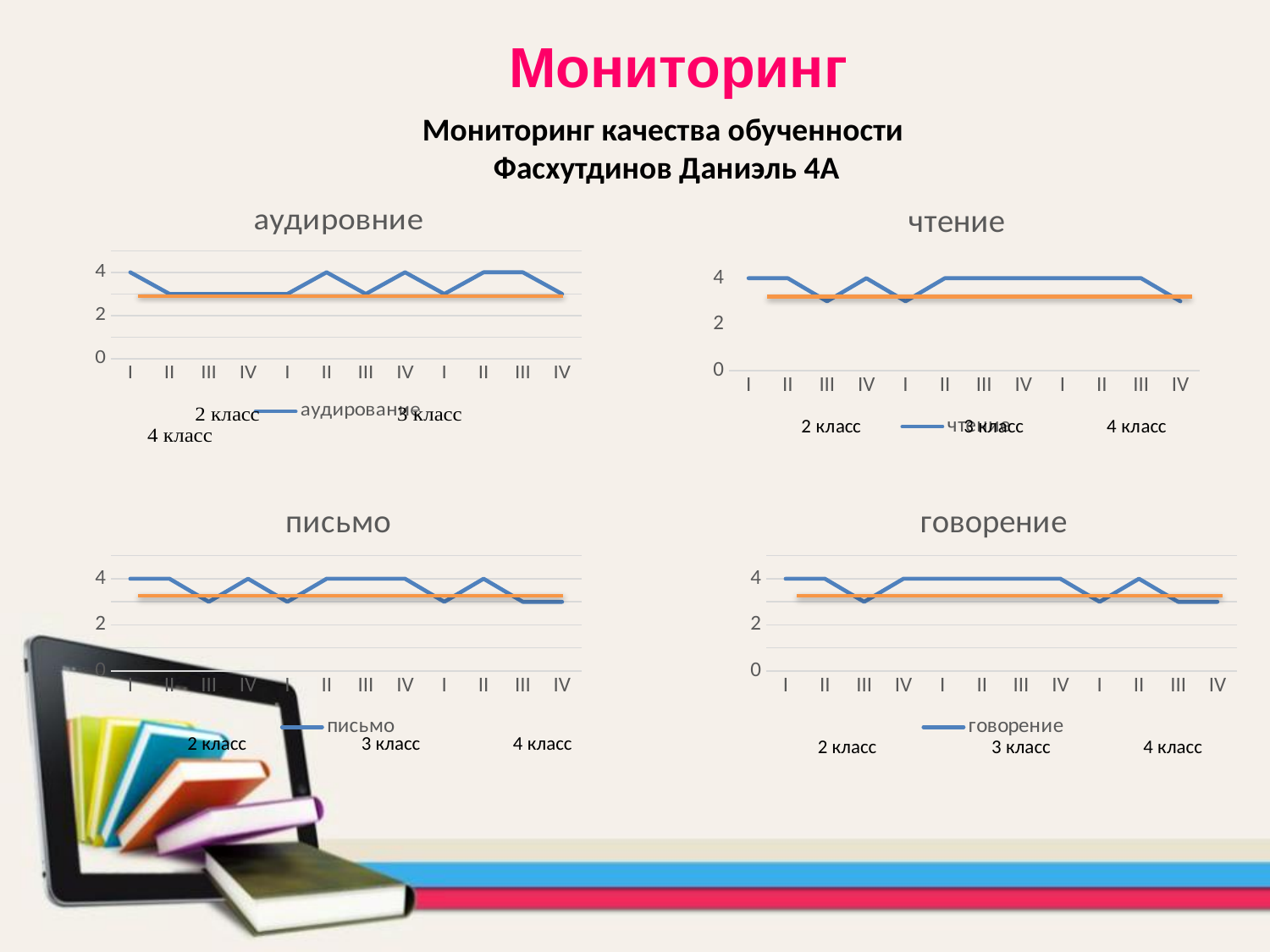
What kind of chart is the 'аудировние' chart? line chart In the 'аудировние' chart, what is the value for quarter I of 2 класс? 4 In the 'говорение' chart, what is the value for quarter IV of 3 класс? 4 In the 'письмо' chart, what is the value for quarter II of 4 класс? 4 In the 'аудировние' chart, how many data points are plotted along the x axis? 12 How many series does the legend of the 'чтение' chart list? 1 In the 'чтение' chart, is the value for quarter IV of 4 класс greater or less than 2? greater What is the title of the chart in the bottom-right of the slide? говорение In the 'говорение' chart, which is larger: the value for quarter I of 3 класс or the value for quarter III of 4 класс? quarter I of 3 класс In the 'аудировние' chart, is the value for quarter II of 2 класс greater or less than 2? greater In the 'чтение' chart, what is the value for quarter I of 2 класс? 4 In the 'письмо' chart, which is larger: the value for quarter III of 2 класс or the value for quarter IV of 2 класс? quarter IV of 2 класс